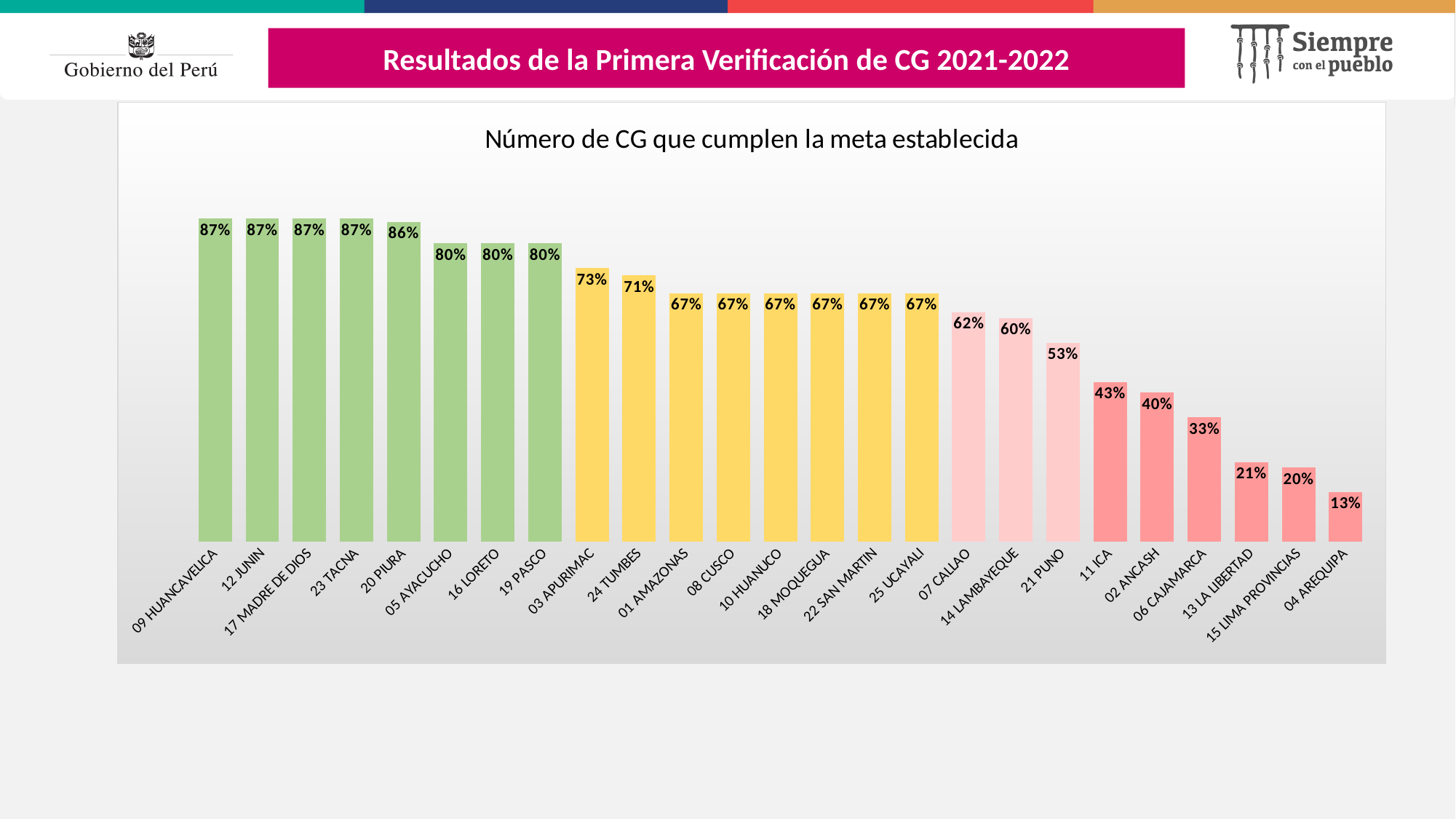
How many categories are shown on the x axis? 25 Which is larger, the value for 07 CALLAO or the value for 11 ICA? 07 CALLAO What is the difference between the values for 09 HUANCAVELICA and 04 AREQUIPA? 74% Which is larger, the value for 13 LA LIBERTAD or the value for 02 ANCASH? 02 ANCASH What is the title of the chart? Número de CG que cumplen la meta establecida What is the value for 20 PIURA? 86% What is the value for 14 LAMBAYEQUE? 60% What is the value for 03 APURIMAC? 73% What is the difference between the values for 24 TUMBES and 21 PUNO? 18% Which category has the lowest value? 04 AREQUIPA What is the value for 06 CAJAMARCA? 33% What kind of chart is shown on the slide? Bar chart